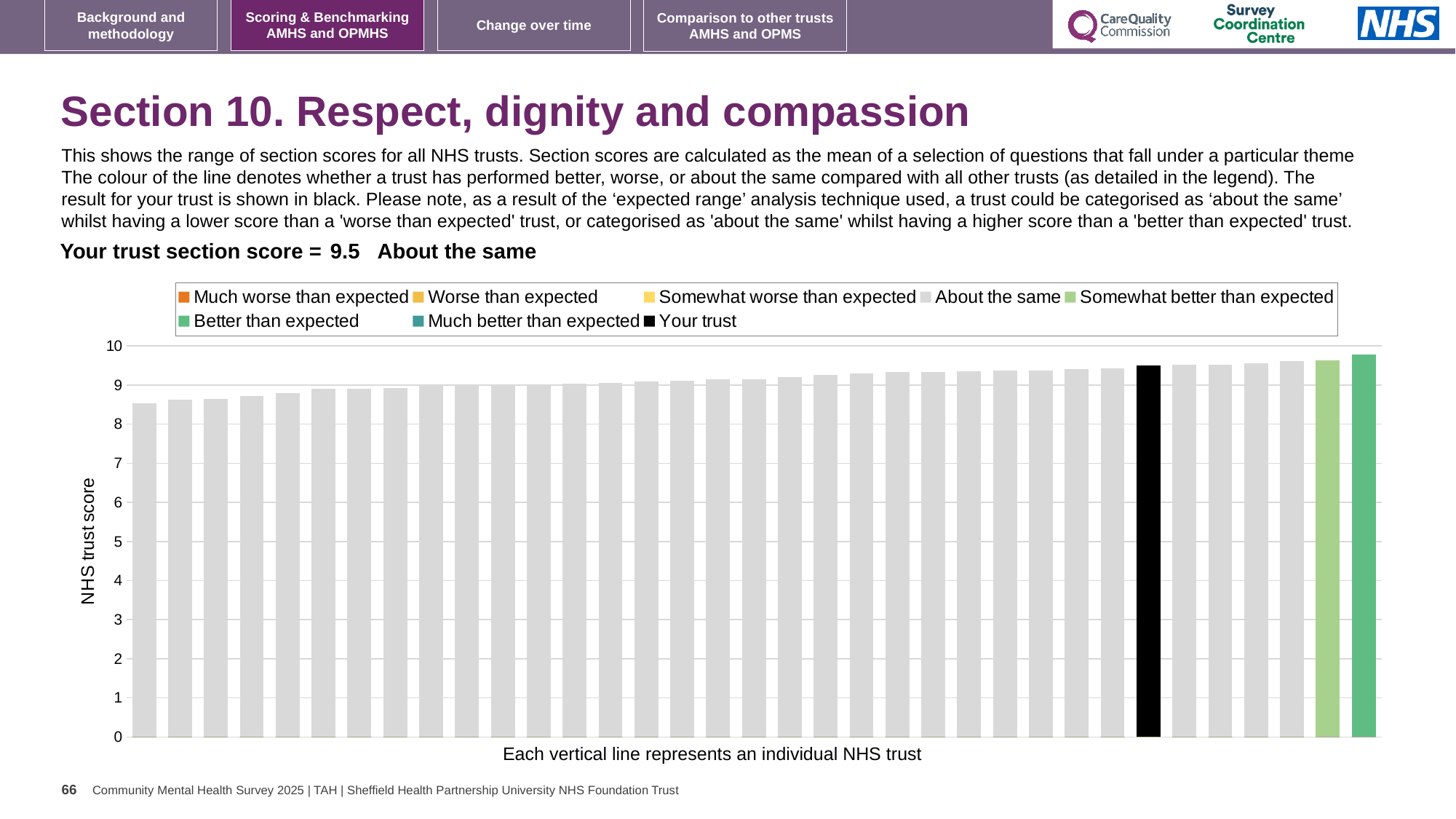
How many bars in the chart are coloured green (not grey or black)? 2 Is the value of the rightmost (highest) bar greater or less than 10? less What kind of chart is shown on the slide? bar chart What is the label on the vertical axis of the chart? NHS trust score Is the black 'Your trust' bar taller or shorter than the rightmost green bar? shorter How many entries does the chart legend list? 8 Is the value of the leftmost (lowest) bar greater or less than 8? greater Do the bar values rise or fall from left to right along the x axis? rise Is the value of the black 'Your trust' bar greater or less than 9? greater Which category is your trust placed in according to the slide? About the same What is the section score for your trust shown on the slide? 9.5